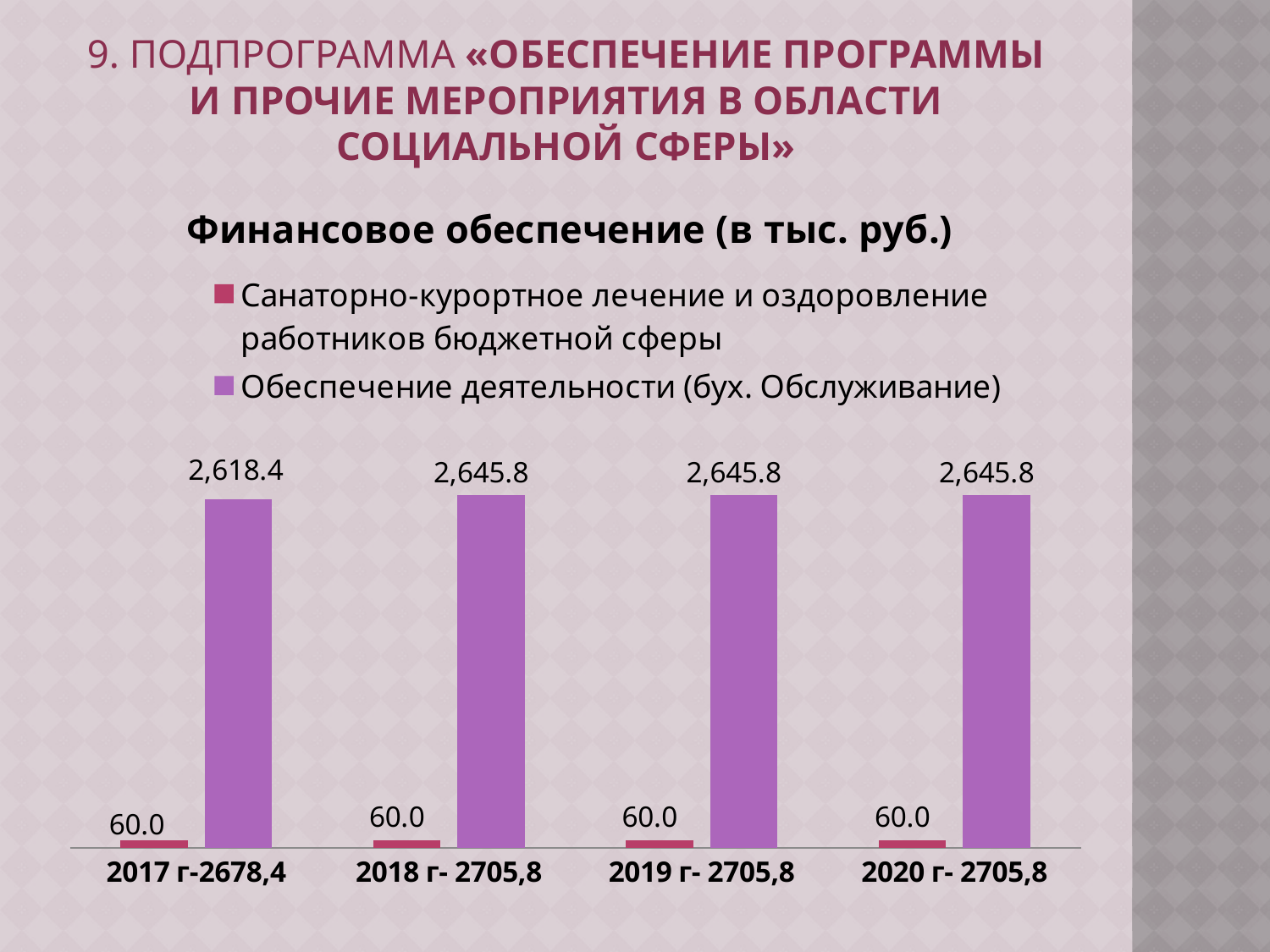
What type of chart is shown on the slide? bar chart Which category has the lowest value for Обеспечение деятельности (бух. Обслуживание)? 2017 г-2678,4 Does the value for Санаторно-курортное лечение и оздоровление работников бюджетной сферы change across the years? No, it stays at 60.0 How many categories are shown on the x axis? 4 What is the difference between the Обеспечение деятельности (бух. Обслуживание) values for 2018 г- 2705,8 and 2017 г-2678,4? 27.4 What is the value for Обеспечение деятельности (бух. Обслуживание) in the category 2017 г-2678,4? 2,618.4 What is the title of the chart? Финансовое обеспечение (в тыс. руб.) What colour are the bars for Обеспечение деятельности (бух. Обслуживание)? purple What is the value for Санаторно-курортное лечение и оздоровление работников бюджетной сферы in the category 2018 г- 2705,8? 60.0 How many series does the legend list? 2 Which series has the larger value in the category 2020 г- 2705,8? Обеспечение деятельности (бух. Обслуживание) What is the value for Обеспечение деятельности (бух. Обслуживание) in the category 2019 г- 2705,8? 2,645.8